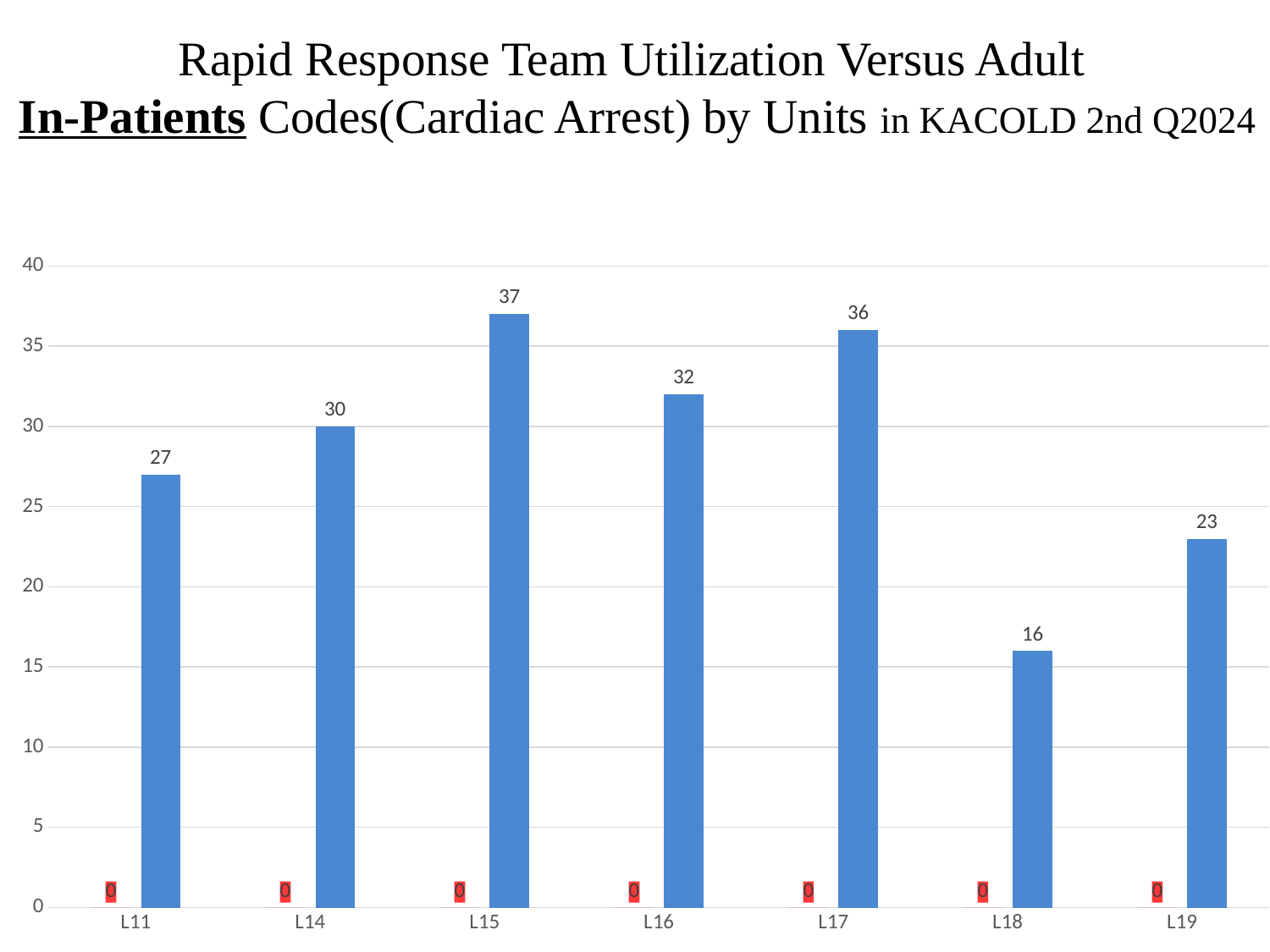
What is the value of the blue bar for L15? 37 What is the difference between the blue bar values for L14 and L11? 3 Which has a larger blue bar value, L16 or L17? L17 What kind of chart is shown on the slide? Bar chart Which unit has the lowest blue bar? L18 What value is shown by the red data label for each unit? 0 What is the value of the blue bar for L18? 16 What is the difference between the blue bar values for L15 and L18? 21 Is the blue bar value for L11 greater or less than 25? greater What is the value of the blue bar for L19? 23 How many units are shown on the x axis? 7 Which unit has the highest blue bar? L15